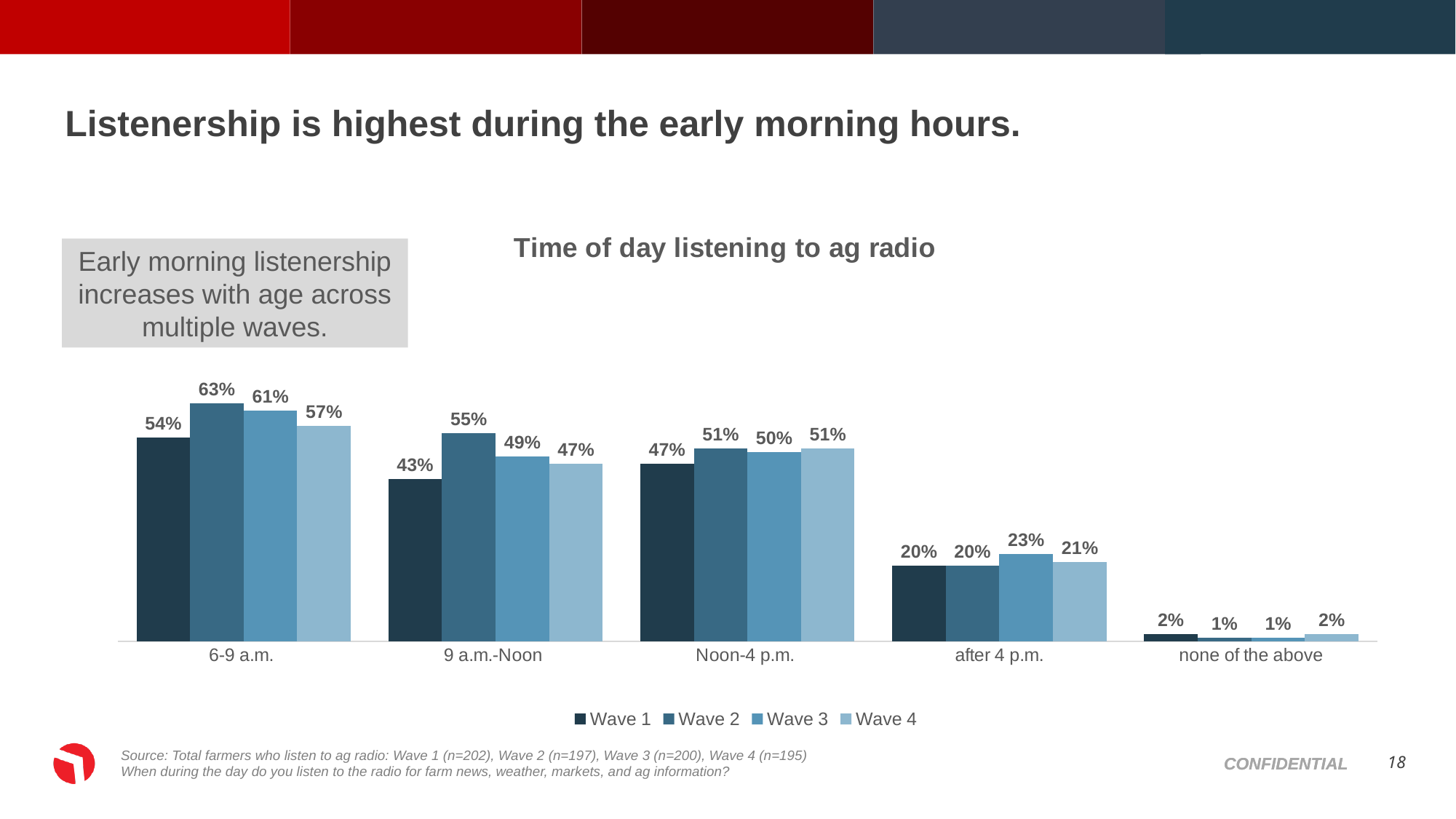
What is the Wave 1 value for 9 a.m.-Noon? 43% How many series does the legend list? 4 What is the difference between the Wave 2 and Wave 1 values for 6-9 a.m.? 9 percentage points What kind of chart is shown on the slide? Bar chart What is the Wave 4 value for Noon-4 p.m.? 51% Which time-of-day category has the highest Wave 1 value? 6-9 a.m. What is the Wave 3 value for after 4 p.m.? 23% What is the title of the chart? Time of day listening to ag radio Which is larger for 9 a.m.-Noon: the Wave 2 value or the Wave 4 value? Wave 2 How many time-of-day categories are shown on the x axis? 5 What is the Wave 2 value for 6-9 a.m.? 63% Which category has the lowest Wave 3 value? none of the above